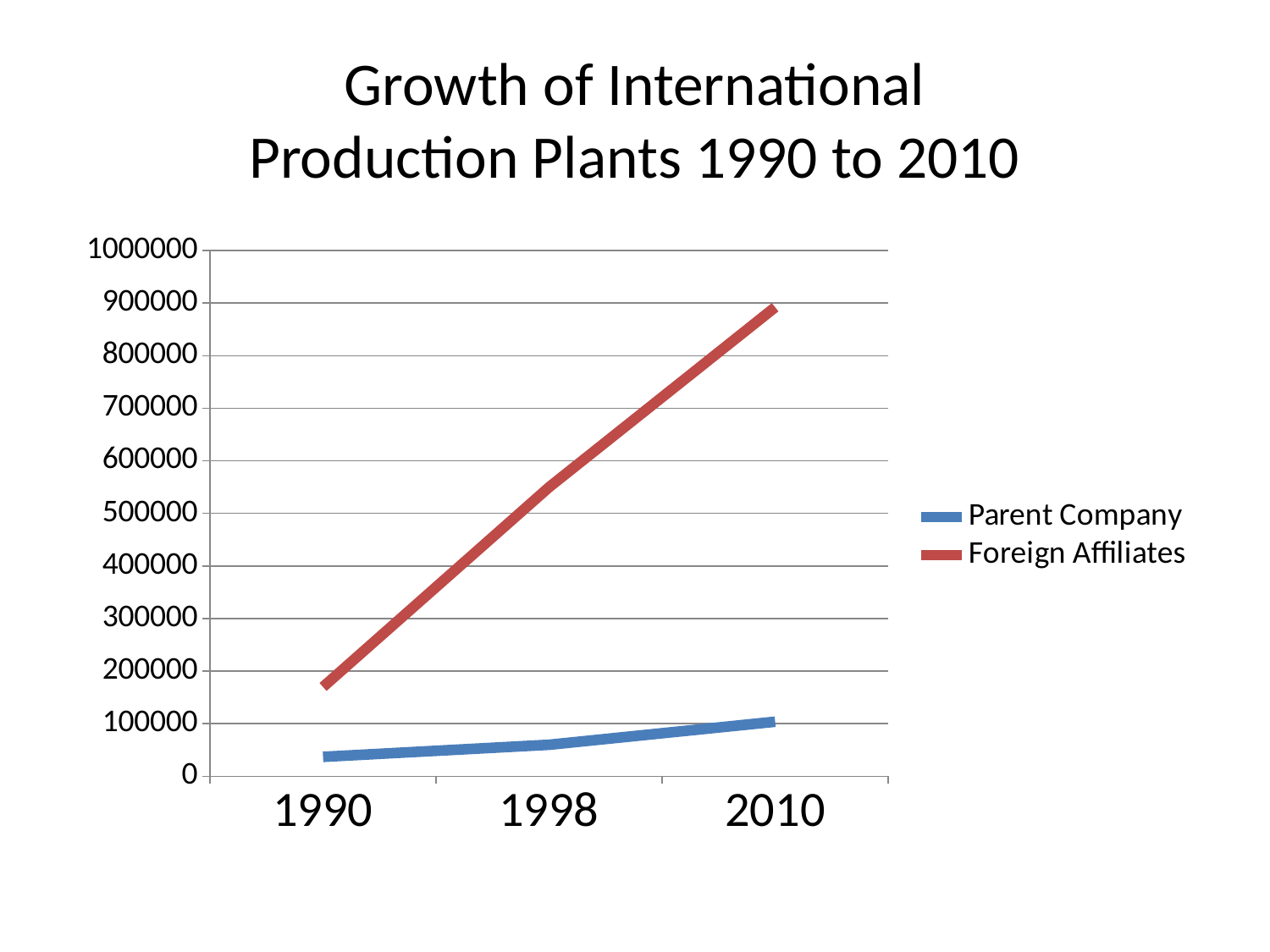
Do the Foreign Affiliates values rise or fall from 1990 to 2010? rise Is the value for Foreign Affiliates in 1990 greater or less than 200000? less What kind of chart is shown on the slide? Line chart Is the value for Foreign Affiliates in 2010 greater or less than 800000? greater In which year is the Foreign Affiliates value highest? 2010 How many series does the legend list? 2 Which series is drawn in red? Foreign Affiliates Is the value for Parent Company in 2010 greater or less than 200000? less Which series has the higher value in 1998, Parent Company or Foreign Affiliates? Foreign Affiliates In which year is the Parent Company value lowest? 1990 How many years are shown on the x axis? 3